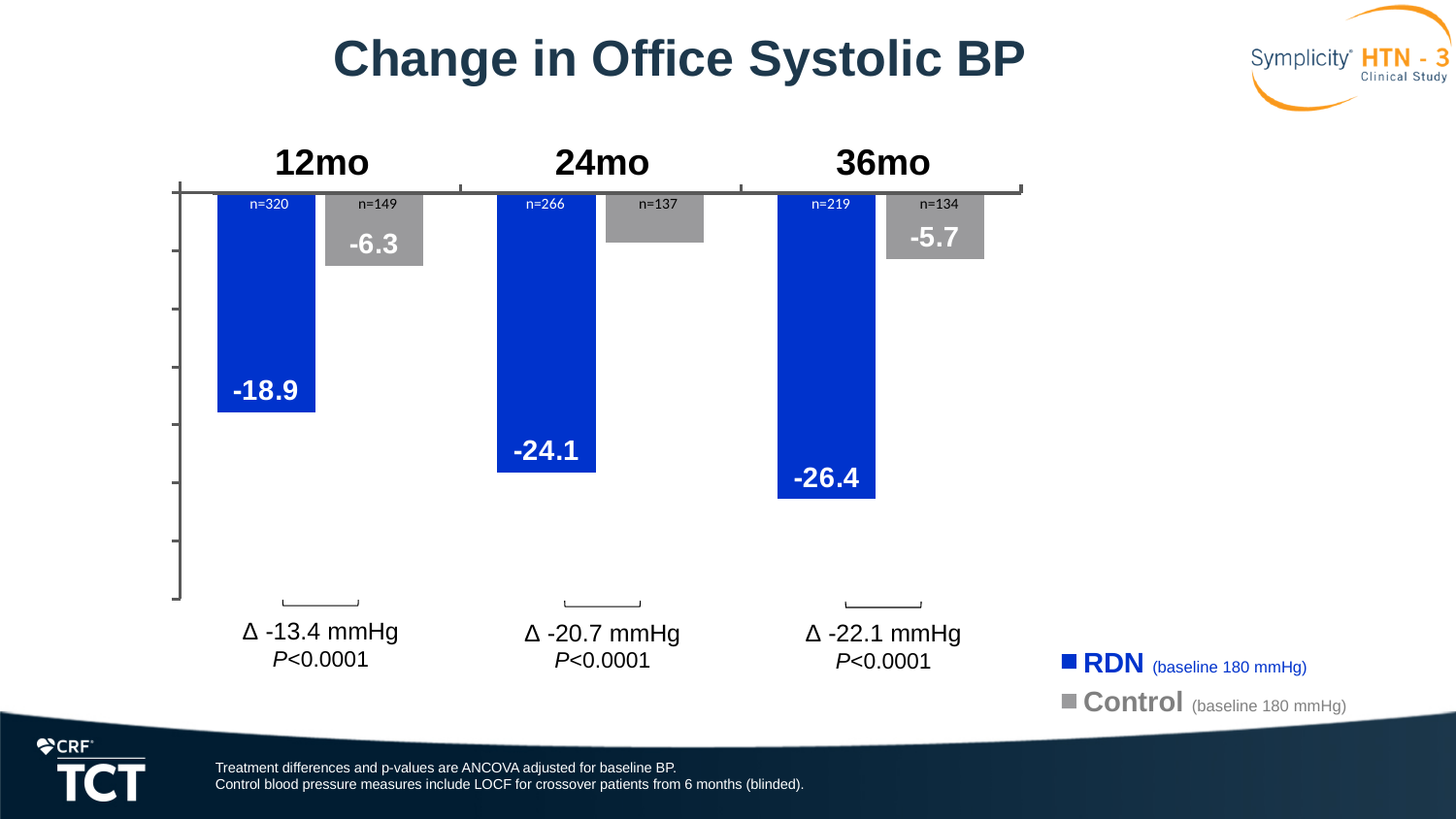
What is the change in office systolic BP for the Control group at 36 months? -5.7 What is the difference between the RDN change at 36 months (-26.4) and at 12 months (-18.9)? 7.5 How many series does the legend list? 2 What is the change in office systolic BP for the Control group at 12 months? -6.3 At which time point does the RDN group show the largest reduction in office systolic BP? 36mo How many time points are shown on the chart? 3 Which group shows a larger reduction in office systolic BP at 12 months, RDN or Control? RDN What is the change in office systolic BP for the RDN group at 12 months? -18.9 What is the change in office systolic BP for the RDN group at 24 months? -24.1 What is the change in office systolic BP for the RDN group at 36 months? -26.4 What is the sample size (n) for the RDN group at 24 months? n=266 What is the treatment difference (Δ) between RDN and Control at 36 months? -22.1 mmHg